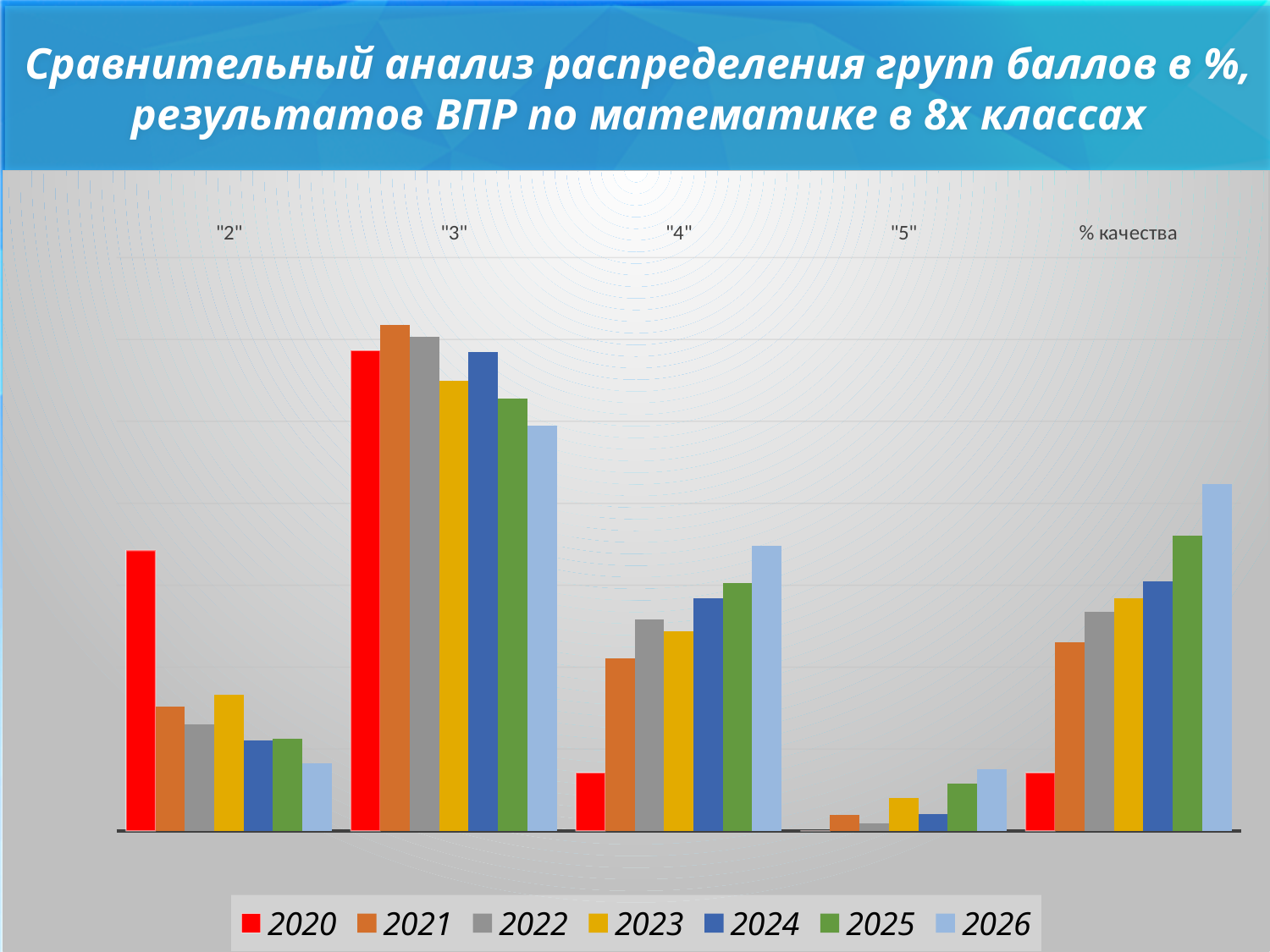
What kind of chart is shown on the slide? bar chart In the "4" category, which year has the highest bar? 2026 In the "2" category, which year has the lowest bar? 2026 How many series does the legend list? 7 Which colour represents the 2020 series in the legend? red In the "3" category, which year has the highest bar? 2021 In the "3" category, which year has the lowest bar? 2026 In the "% качества" category, do the bars rise or fall from 2020 to 2026? rise How many categories are shown along the x axis of the chart? 5 In the "% качества" category, which year has the lowest bar? 2020 In the "2" category, which year has the highest bar? 2020 In the "4" category, which is larger: the bar for 2024 or the bar for 2025? 2025